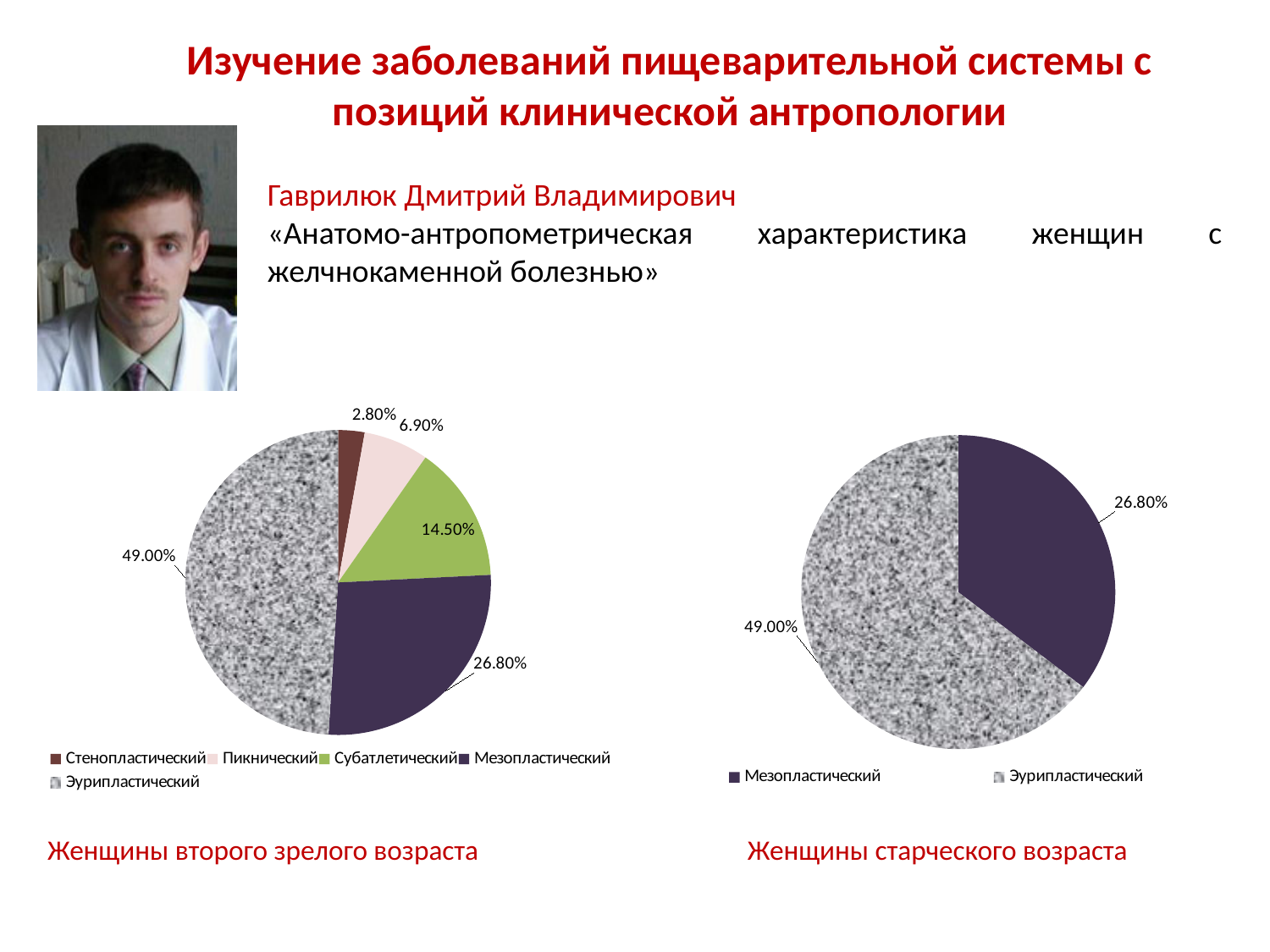
In the left pie chart (Женщины второго зрелого возраста), what is the value for Пикнический? 6.90% In the left pie chart (Женщины второго зрелого возраста), what is the value for Субатлетический? 14.50% How many categories does the legend of the left pie chart (Женщины второго зрелого возраста) list? 5 In the left pie chart (Женщины второго зрелого возраста), which is larger: Пикнический or Стенопластический? Пикнический In the left pie chart (Женщины второго зрелого возраста), what is the value for Эурипластический? 49.00% In the right pie chart (Женщины старческого возраста), what is the value for Мезопластический? 26.80% How many categories does the legend of the right pie chart (Женщины старческого возраста) list? 2 In the left pie chart (Женщины второго зрелого возраста), which category has the largest slice? Эурипластический In the left pie chart (Женщины второго зрелого возраста), which category has the smallest slice? Стенопластический What type of chart is used for Женщины старческого возраста on the right of the slide? Pie chart In the right pie chart (Женщины старческого возраста), which category has the larger slice? Эурипластический In the left pie chart (Женщины второго зрелого возраста), what is the difference between Мезопластический and Субатлетический? 12.30%